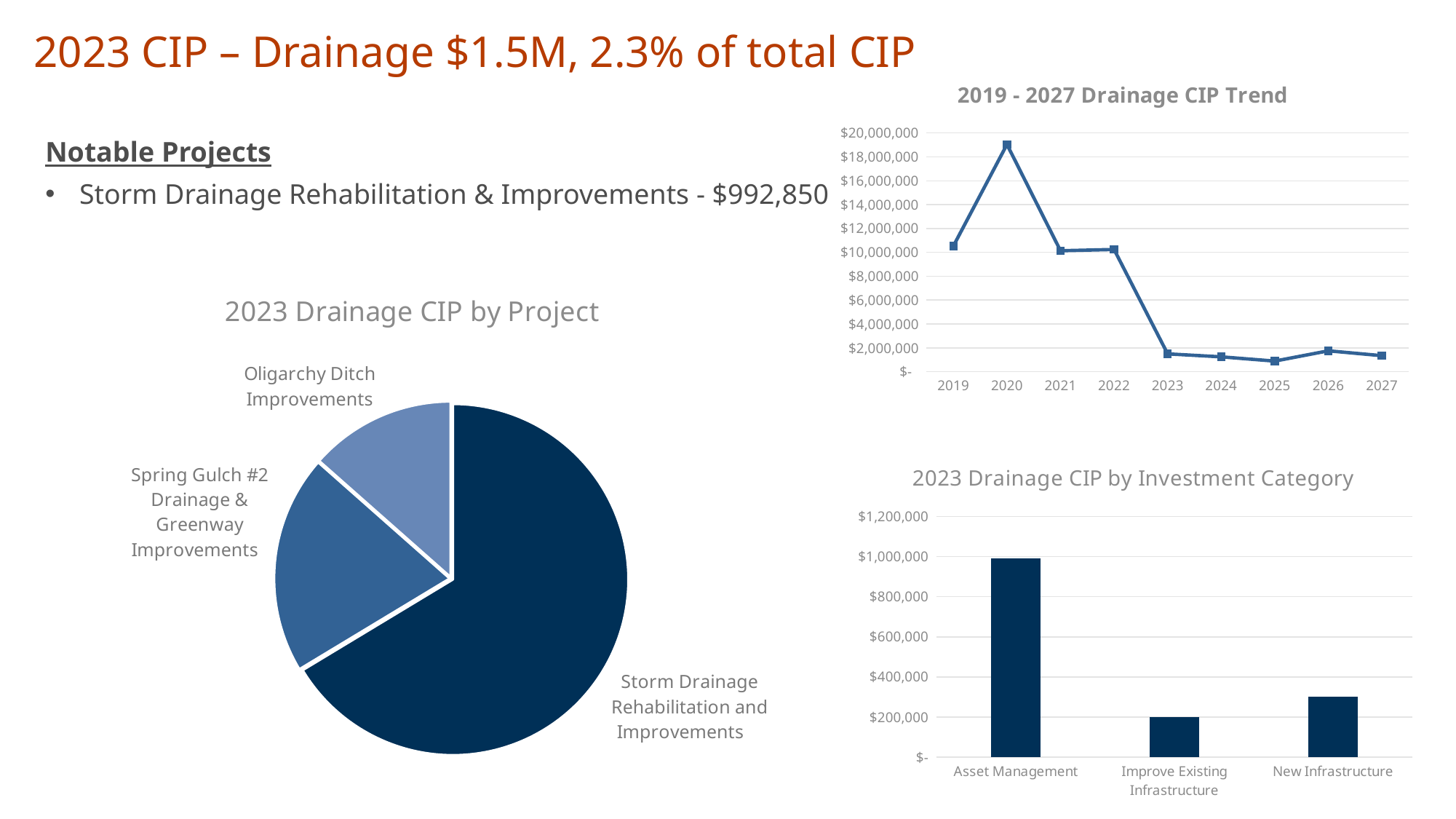
In the '2019 - 2027 Drainage CIP Trend' chart, does the value rise or fall from 2022 to 2023? Fall In the '2019 - 2027 Drainage CIP Trend' chart, is the value for 2020 greater or less than $16,000,000? greater In the '2019 - 2027 Drainage CIP Trend' chart, which year has the lowest value? 2025 In the '2023 Drainage CIP by Investment Category' chart, is the value for Asset Management greater or less than $800,000? greater What kind of chart is the '2019 - 2027 Drainage CIP Trend' chart? Line chart What kind of chart is the '2023 Drainage CIP by Project' chart? Pie chart In the '2019 - 2027 Drainage CIP Trend' chart, which year has the highest value? 2020 What kind of chart is the '2023 Drainage CIP by Investment Category' chart? Bar chart In the '2023 Drainage CIP by Project' pie chart, which project has the largest slice? Storm Drainage Rehabilitation and Improvements In the '2023 Drainage CIP by Project' pie chart, how many slices are there? 3 In the '2023 Drainage CIP by Investment Category' chart, which category has the highest value? Asset Management In the '2019 - 2027 Drainage CIP Trend' chart, how many years are plotted? 9